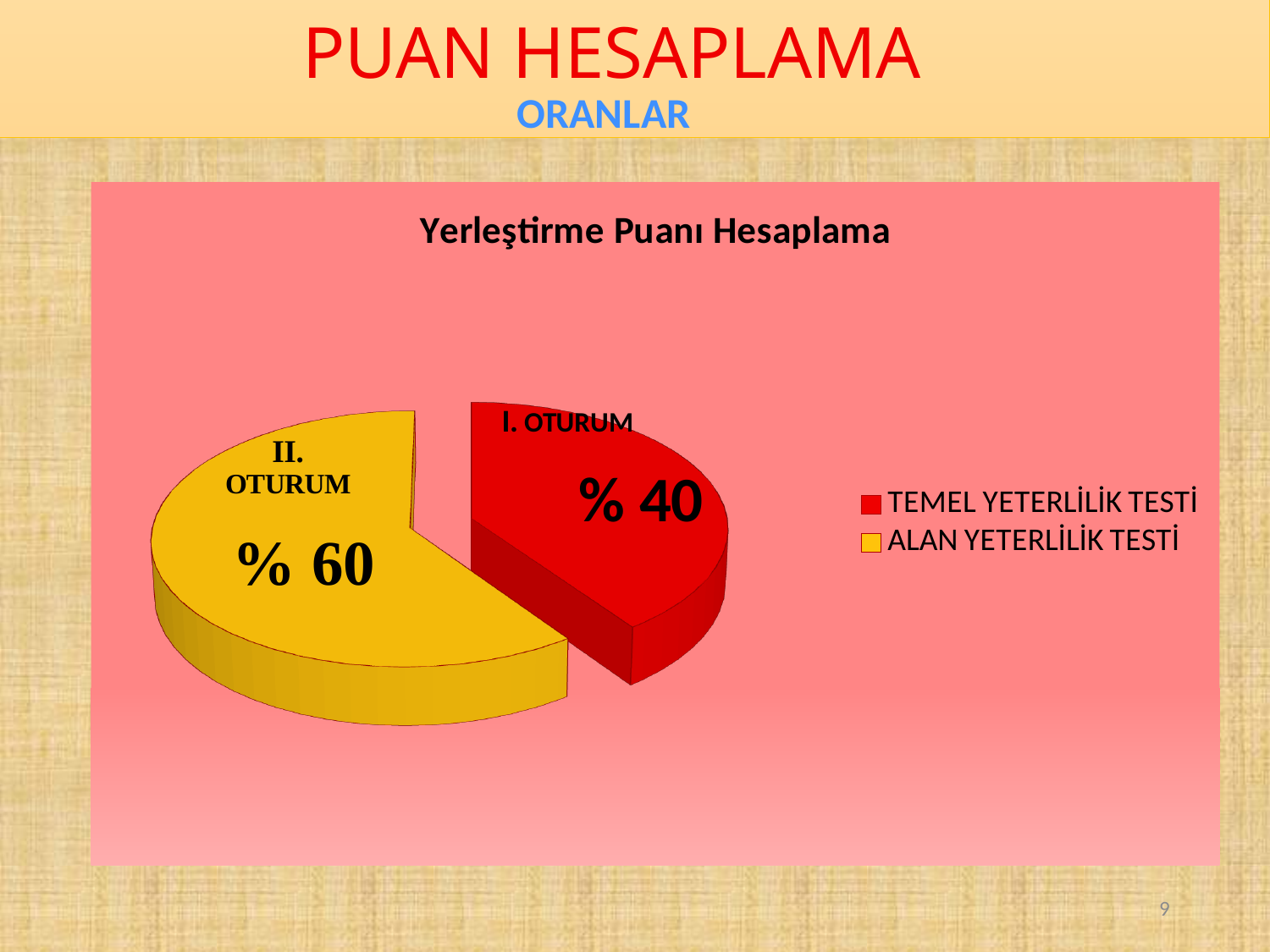
How many slices does the pie chart have? 2 What colour is the slice for TEMEL YETERLİLİK TESTİ? Red What is the difference in percentage points between the II. OTURUM slice and the I. OTURUM slice? 20 What percentage is shown for ALAN YETERLİLİK TESTİ (II. OTURUM)? % 60 How many entries does the legend list? 2 Which slice of the pie is the largest? ALAN YETERLİLİK TESTİ What kind of chart is shown on the slide? Pie chart Which slice of the pie is the smallest? TEMEL YETERLİLİK TESTİ What percentage is shown for TEMEL YETERLİLİK TESTİ (I. OTURUM)? % 40 What share of the pie does the I. OTURUM slice represent? % 40 Which is larger, the share for I. OTURUM or the share for II. OTURUM? II. OTURUM What is the chart's title? Yerleştirme Puanı Hesaplama